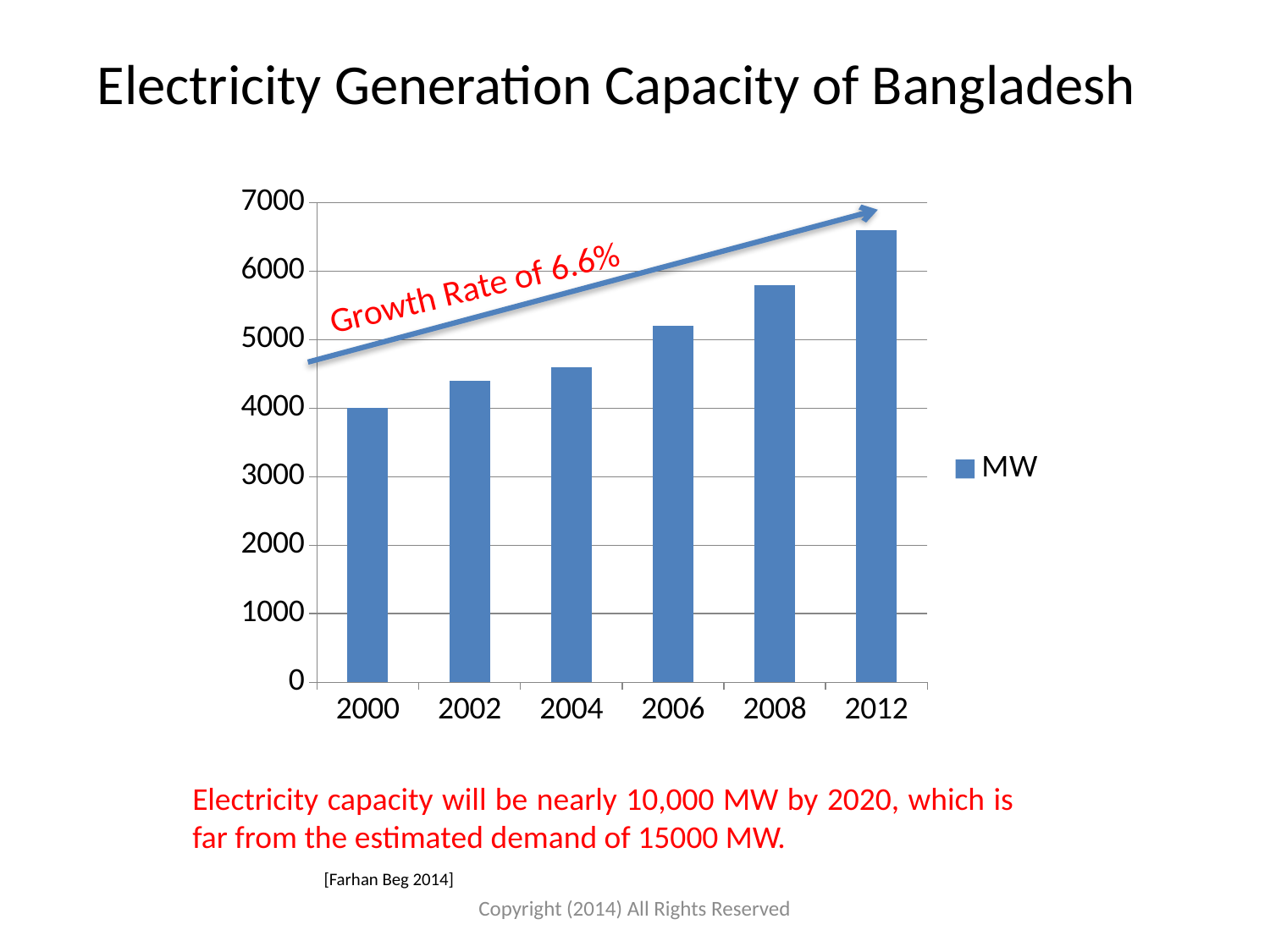
Which year has the highest electricity generation capacity? 2012 What kind of chart is shown on the slide? bar chart Is the value for 2004 greater or less than 5000? less Do the values rise or fall from 2000 to 2012? rise Is the value for 2012 greater or less than 6000? greater Is the value for 2006 greater or less than 5000? greater How many series does the legend list? 1 Which is larger, the value for 2008 or the value for 2006? 2008 What is the name of the series in the legend? MW Which year has the lowest electricity generation capacity? 2000 How many years are shown on the x axis of the chart? 6